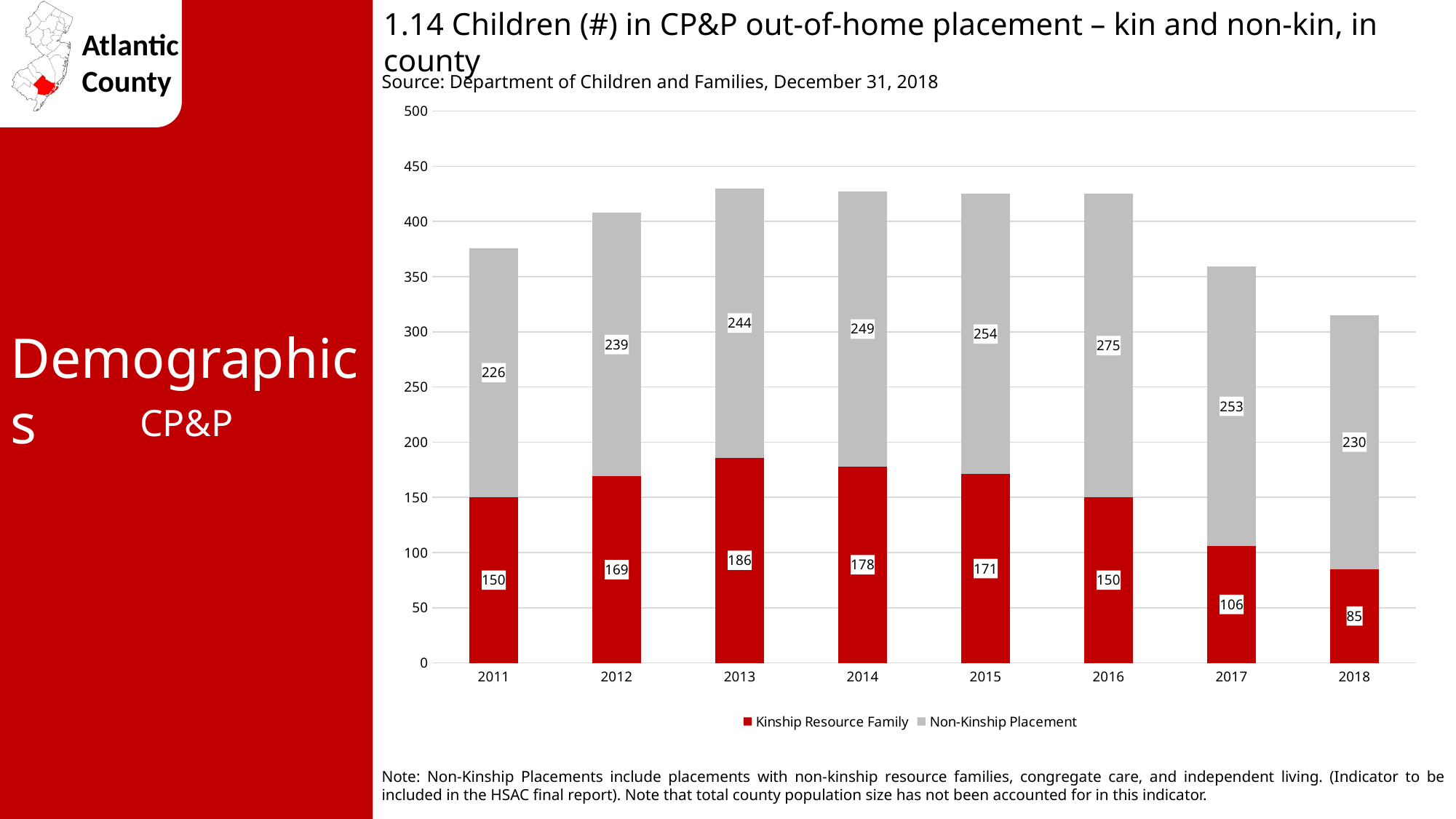
What kind of chart is shown on the slide? Stacked bar chart How many series does the legend list? 2 Which is larger, the Kinship Resource Family value in 2012 or in 2015? 2015 Which year has the lowest Kinship Resource Family value? 2018 What is the Non-Kinship Placement value for 2016? 275 What is the Kinship Resource Family value for 2013? 186 What is the Kinship Resource Family value for 2018? 85 What is the total of the stacked bar for 2018? 315 What is the total of the stacked bar for 2013? 430 How many years are shown on the x axis? 8 What is the difference between the Non-Kinship Placement value and the Kinship Resource Family value in 2017? 147 Which year has the highest Non-Kinship Placement value? 2016